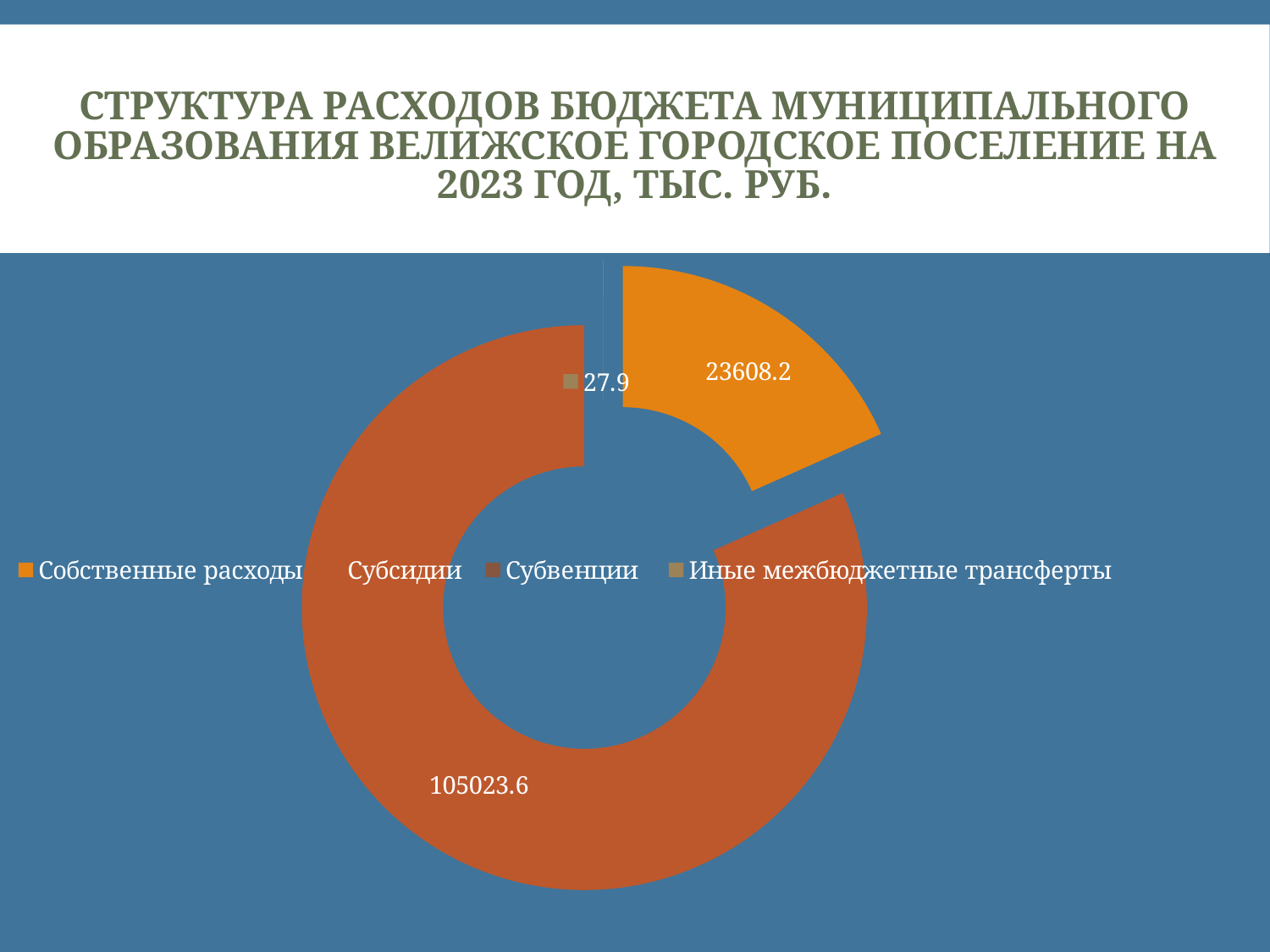
What is the value shown for the Иные межбюджетные трансферты slice? 27.9 What type of chart is shown on the slide? Doughnut (pie) chart Which is larger: Собственные расходы or Иные межбюджетные трансферты? Собственные расходы What year does the chart title refer to? 2023 What is the difference between the Собственные расходы value and the Иные межбюджетные трансферты value? 23580.3 What is the value printed on the largest slice of the chart? 105023.6 Which labelled category has the smallest value in the chart? Иные межбюджетные трансферты What is the difference between the largest slice value (105023.6) and the Собственные расходы value? 81415.4 In what units are the values given according to the title? тыс. руб. How many categories does the legend list? 4 What is the value shown for the Собственные расходы slice? 23608.2 Which category has the largest slice in the chart? Субсидии